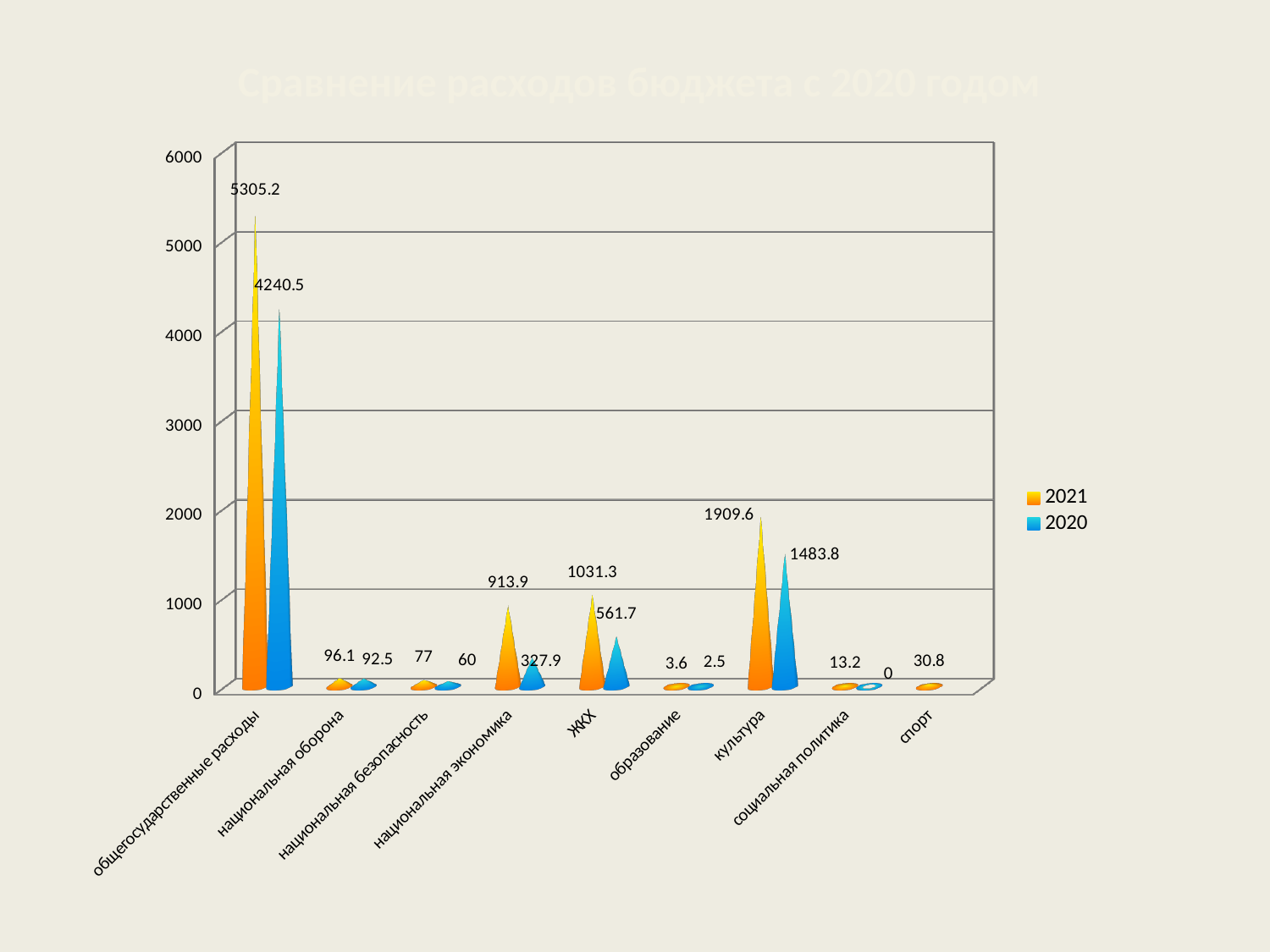
How many series does the legend list? 2 What is the 2020 value for культура? 1483.8 Which category has the highest 2021 value? общегосударственные расходы What is the 2021 value for общегосударственные расходы? 5305.2 Which is larger for культура, the 2021 value or the 2020 value? 2021 What is the 2020 value for национальная экономика? 327.9 What is the 2021 value for ЖКХ? 1031.3 What is the difference between the 2021 and 2020 values for ЖКХ? 469.6 Which category has the lowest 2021 value? образование What kind of chart is shown on the slide? bar chart What is the difference between the 2021 and 2020 values for общегосударственные расходы? 1064.7 How many categories are shown on the x axis? 9